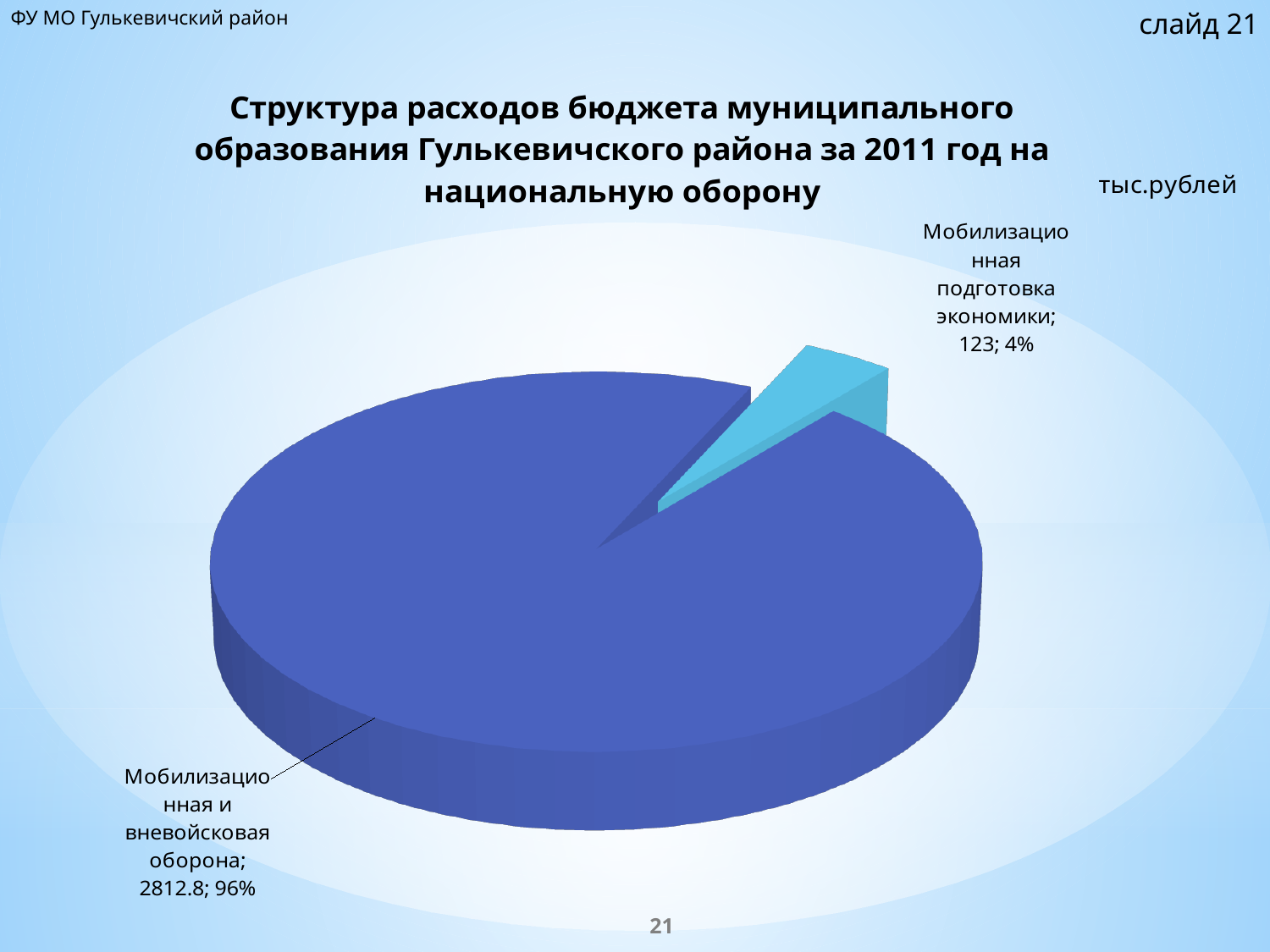
What share of the pie does Мобилизационная и вневойсковая оборона represent? 96% Which category has the smallest slice? Мобилизационная подготовка экономики How many slices does the pie chart have? 2 What is the difference between the values for Мобилизационная и вневойсковая оборона and Мобилизационная подготовка экономики? 2689.8 What is the total of the two slices in the pie chart? 2935.8 In what units are the values on the chart given? тыс.рублей What kind of chart is shown on the slide? pie chart What is the value for Мобилизационная и вневойсковая оборона? 2812.8 What is the value for Мобилизационная подготовка экономики? 123 Which category has the largest slice? Мобилизационная и вневойсковая оборона What share of the pie does Мобилизационная подготовка экономики represent? 4% Which is larger: Мобилизационная и вневойсковая оборона or Мобилизационная подготовка экономики? Мобилизационная и вневойсковая оборона